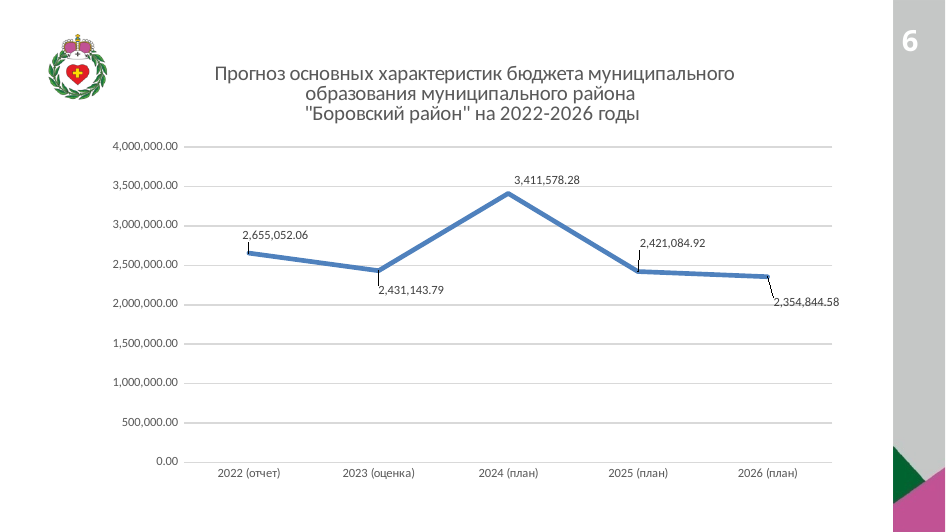
What is the difference between the values for 2025 (план) and 2026 (план)? 66,240.34 Is the value for 2024 (план) greater or less than 3,000,000.00? greater Which category has the highest value? 2024 (план) What is the difference between the values for 2024 (план) and 2022 (отчет)? 756,526.22 What is the value for 2022 (отчет)? 2,655,052.06 Which category has the lowest value? 2026 (план) What is the value for 2023 (оценка)? 2,431,143.79 How many data points are plotted on the chart? 5 What is the value for 2024 (план)? 3,411,578.28 What kind of chart is shown on the slide? line chart What is the value for 2026 (план)? 2,354,844.58 Which is larger, the value for 2022 (отчет) or the value for 2026 (план)? 2022 (отчет)